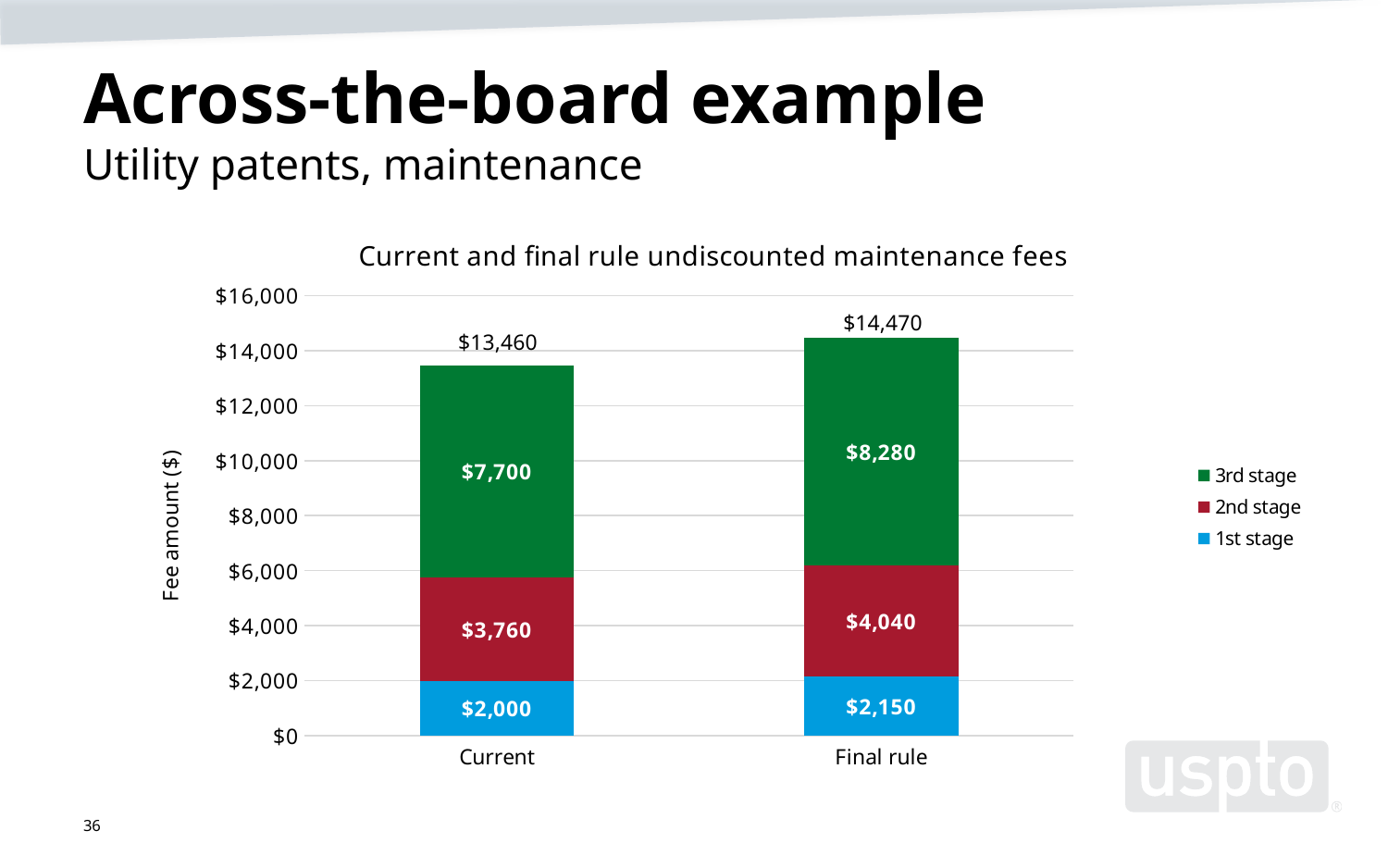
What is the 1st stage fee under the Final rule? $2,150 What is the title of the chart? Current and final rule undiscounted maintenance fees What is the total undiscounted maintenance fee for the Final rule bar? $14,470 Which stage has the lowest fee in the Current bar? 1st stage What is the 2nd stage fee under the Final rule? $4,040 What is the total undiscounted maintenance fee for the Current bar? $13,460 How many series does the legend list? 3 What is the 3rd stage fee for the Current bar? $7,700 What is the difference between the Final rule total and the Current total? $1,010 How much higher is the 3rd stage fee under the Final rule than under Current? $580 What type of chart is shown? Stacked bar chart Which bar has the higher total, Current or Final rule? Final rule